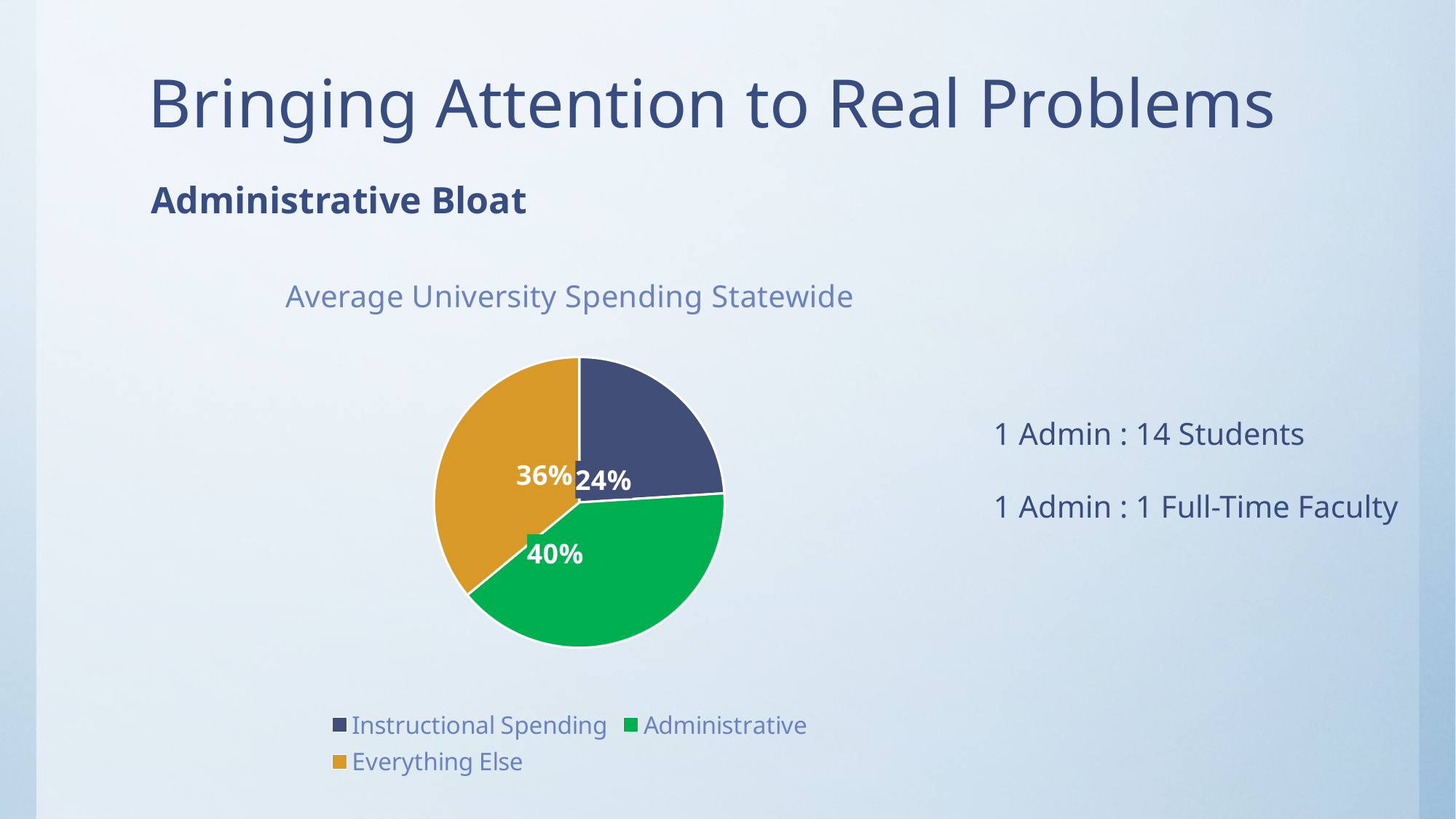
What share of spending is Instructional Spending? 24% What share of spending is Administrative? 40% Which category has the smallest share of the pie? Instructional Spending What colour is the Administrative slice? green What is the difference in percentage points between Administrative and Instructional Spending? 16 What share of spending is Everything Else? 36% What is the title of the chart? Average University Spending Statewide What kind of chart is shown on the slide? pie chart How many entries does the legend list? 3 How many categories does the pie chart show? 3 Which category has the largest share of the pie? Administrative Which is larger, the share for Everything Else or the share for Instructional Spending? Everything Else